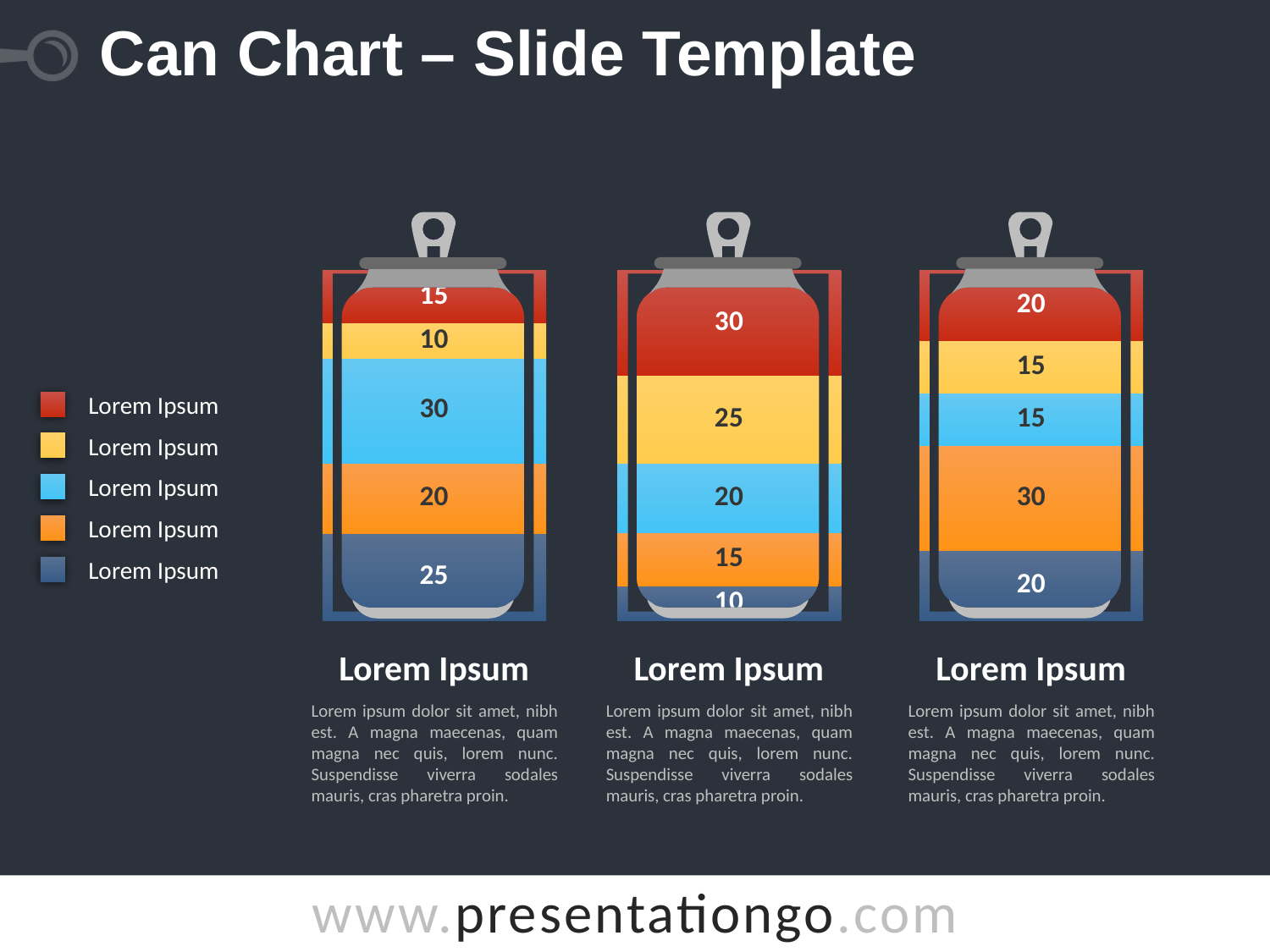
In the left can, what is the value of the light blue segment? 30 How many segments does each can contain? 5 In the middle can, which coloured segment has the smallest value? dark blue How many entries does the legend list? 5 Which is larger: the yellow segment in the middle can or the yellow segment in the right can? the middle can In the left can, which coloured segment has the largest value? light blue In the middle can, what is the value of the dark blue segment at the bottom? 10 What is the total of all segments in the right can? 100 What is the total of all segments in the left can? 100 In the right can, what is the value of the orange segment? 30 What is the difference between the red segment in the middle can and the red segment in the left can? 15 In the middle can, what is the value of the red segment at the top? 30